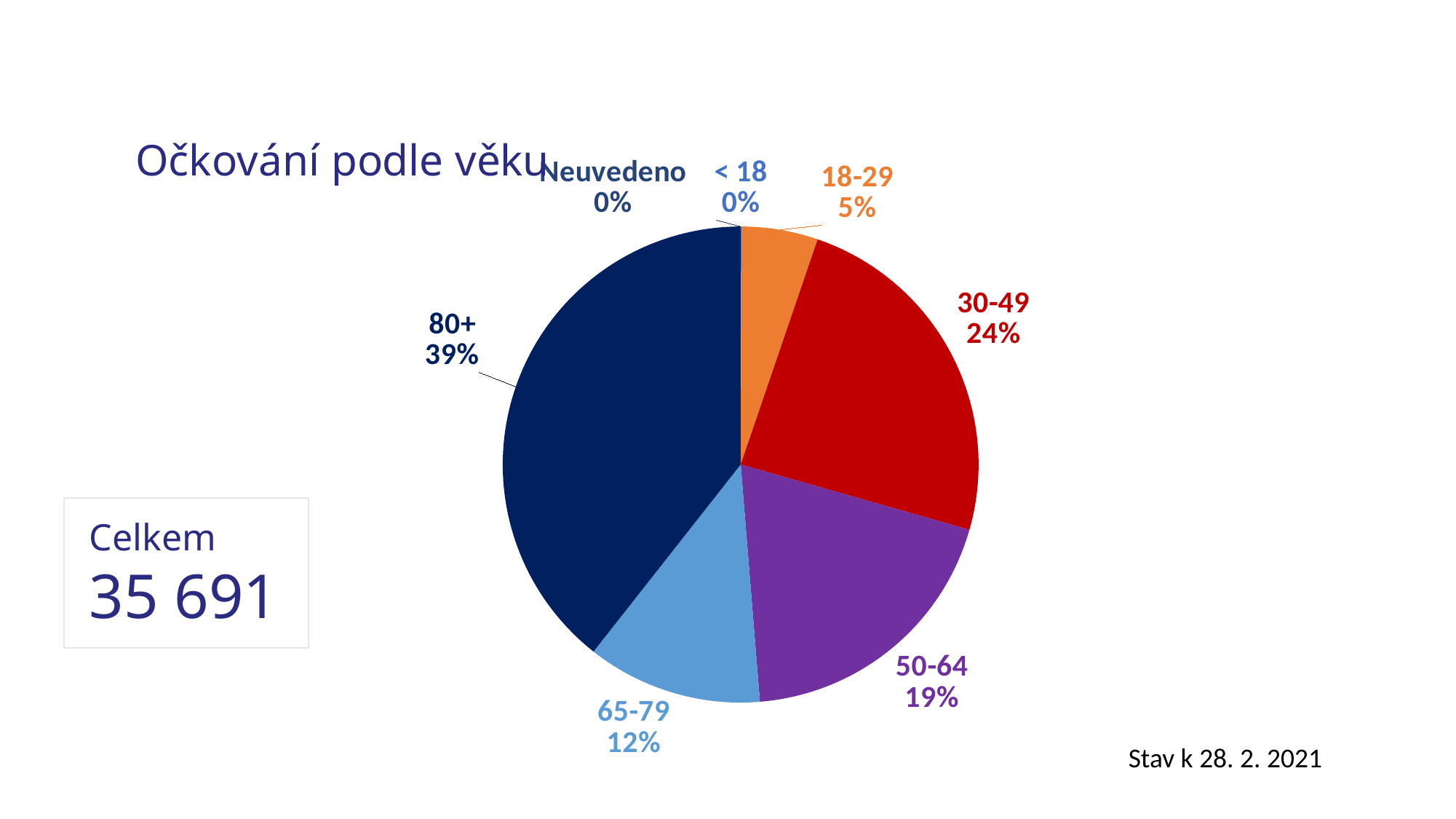
What percentage is shown for the 18-29 age group? 5% How many categories are labelled on the pie chart? 7 What share of the pie does the 80+ age group have? 39% Which age group has the largest share of the pie? 80+ Which has the larger share, 50-64 or 65-79? 50-64 What total (Celkem) is shown on the slide? 35 691 What is the title of the chart? Očkování podle věku What is the difference in percentage points between the 80+ and 30-49 groups? 15 What percentage is shown for the 30-49 age group? 24% What kind of chart is shown on the slide? Pie chart What percentage is shown for the 50-64 age group? 19% What percentage is shown for the 65-79 age group? 12%